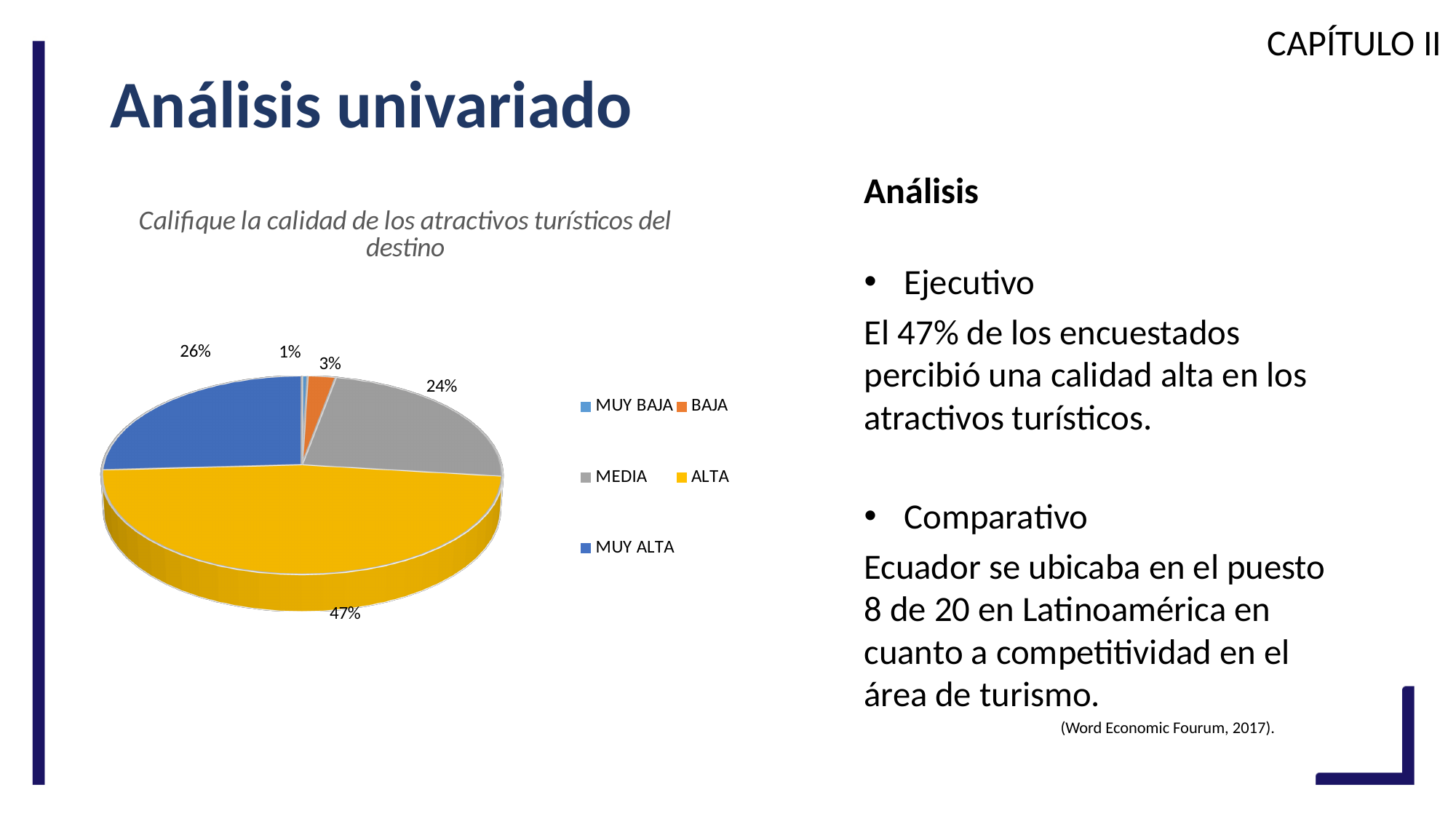
What is the title of the pie chart? Califique la calidad de los atractivos turísticos del destino What share of the pie does MEDIA represent? 24% What share of the pie does ALTA represent? 47% Which category has the largest slice of the pie? ALTA What share of the pie does BAJA represent? 3% What is the difference in percentage points between the ALTA and MUY ALTA slices? 21% How many categories does the legend of the pie chart list? 5 Which category has the smallest slice of the pie? MUY BAJA What kind of chart is shown on the slide? pie chart Which slice is larger, MEDIA or MUY ALTA? MUY ALTA